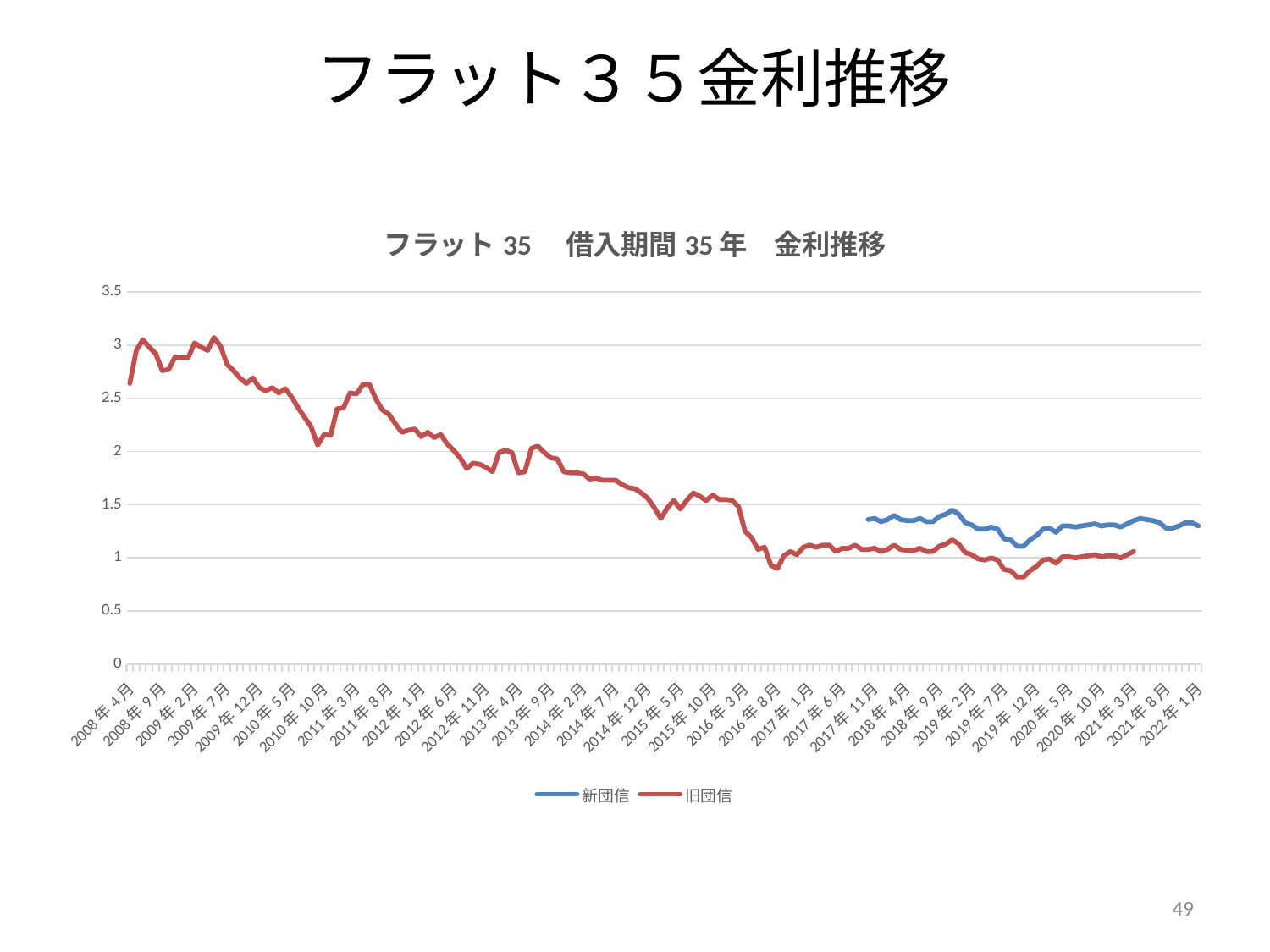
Is the value for 旧団信 at 2016年8月 greater or less than 1.5? less Which series starts earlier on the x axis, 新団信 or 旧団信? 旧団信 Around 2019年7月, which series has the higher value, 新団信 or 旧団信? 新団信 How many series does the legend list? 2 Is the value for 旧団信 at 2019年12月 greater or less than 1? less What kind of chart is shown on the slide? line chart What is the title of the chart? フラット35 借入期間35年 金利推移 Is the value for 旧団信 at 2009年7月 greater or less than 2.5? greater Does the 旧団信 line generally rise or fall from 2008年4月 to 2021年3月? fall Which series is drawn in blue? 新団信